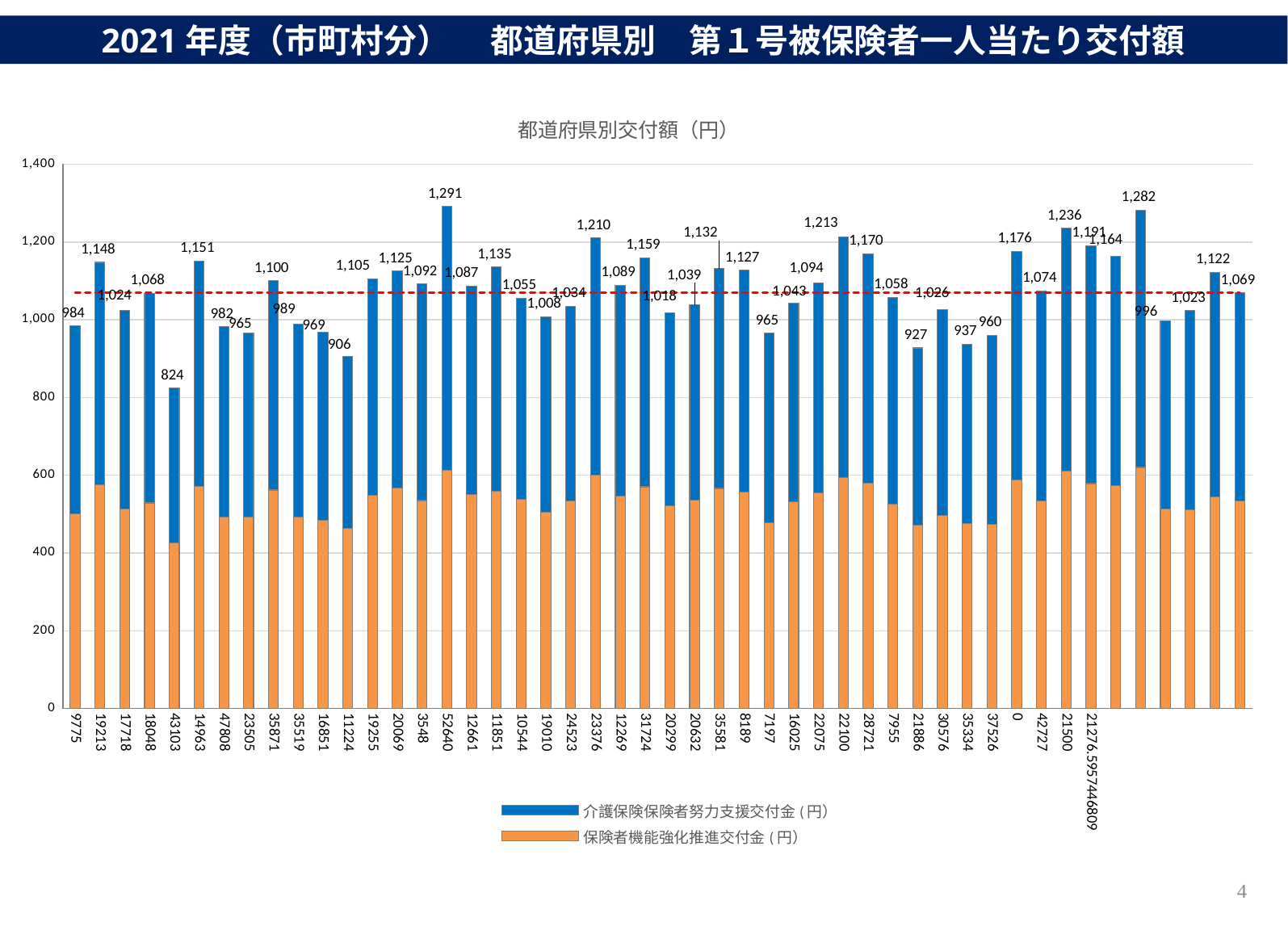
Is the orange (保険者機能強化推進交付金) segment for category 9775 greater or less than 600? less Which has the larger total, category 19213 or category 17718? 19213 Which category has the highest total value? 52640 What is the total value labelled for the category 9775? 984 What is the title of the chart? 都道府県別交付額（円） What kind of chart is shown on the slide? stacked bar chart How many series does the legend list? 2 What is the total value labelled for the category 52640? 1,291 What is the total value labelled for the category 43103? 824 Which category has the lowest total value? 43103 What is the total value labelled for the category 23376? 1,210 What is the difference between the total for 52640 and the total for 43103? 467